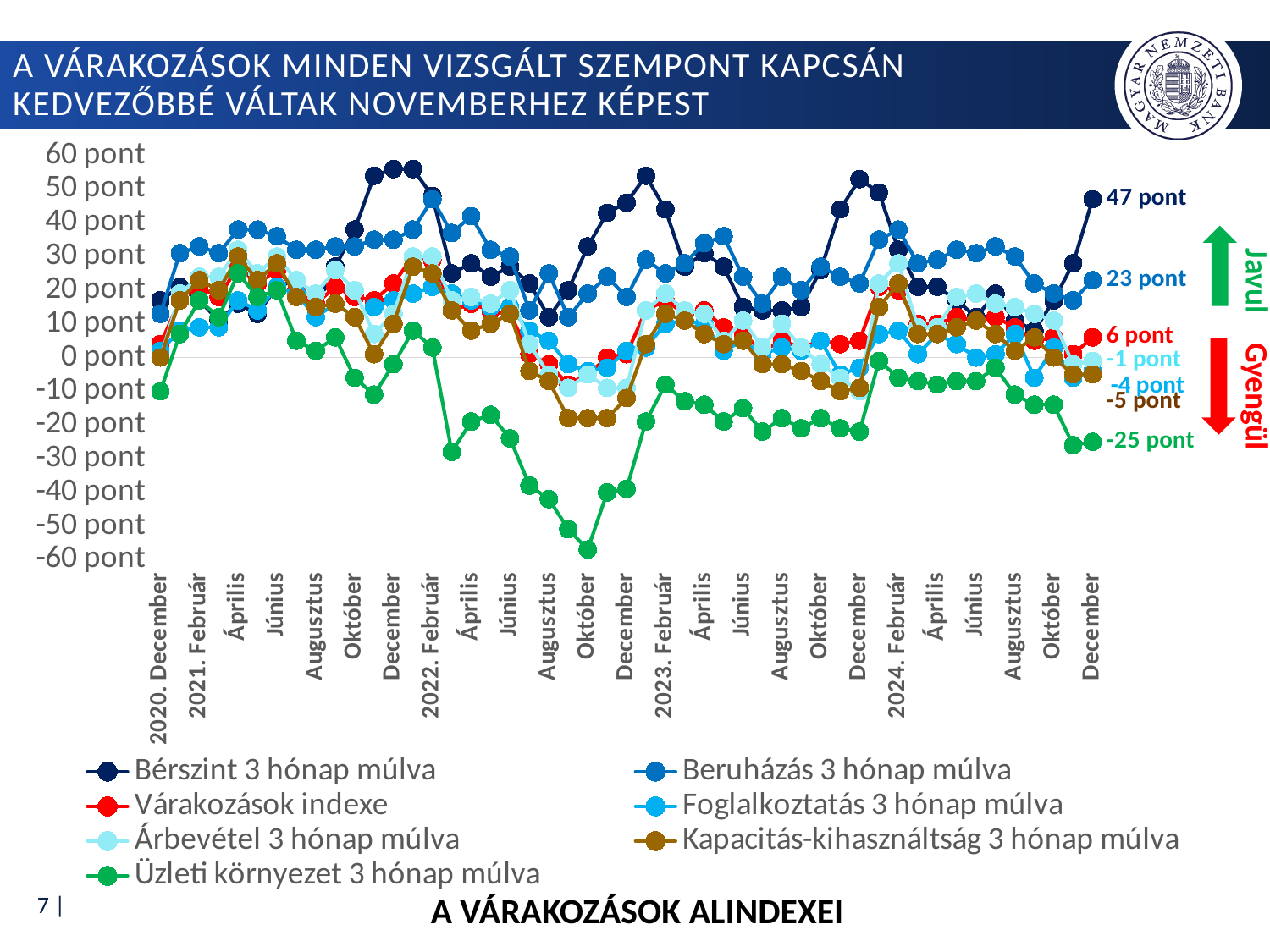
At the end of the chart, which is larger: the Várakozások indexe value or the Foglalkoztatás 3 hónap múlva value? Várakozások indexe Which series has the lowest labelled value at the end of the chart (December)? Üzleti környezet 3 hónap múlva What kind of chart is shown on the slide? line chart What is the final (December) value labelled for the Üzleti környezet 3 hónap múlva series? -25 pont Which series has the highest labelled value at the end of the chart (December)? Bérszint 3 hónap múlva What is the final (December) value labelled for the Kapacitás-kihasználtság 3 hónap múlva series? -5 pont What is the final (December) value labelled for the Bérszint 3 hónap múlva series? 47 pont What is the title shown below the chart? A VÁRAKOZÁSOK ALINDEXEI What is the final (December) value labelled for the Várakozások indexe series? 6 pont How many series does the legend list? 7 What is the difference between the final labelled values of Bérszint 3 hónap múlva (47 pont) and Beruházás 3 hónap múlva (23 pont)? 24 pont What is the final (December) value labelled for the Beruházás 3 hónap múlva series? 23 pont